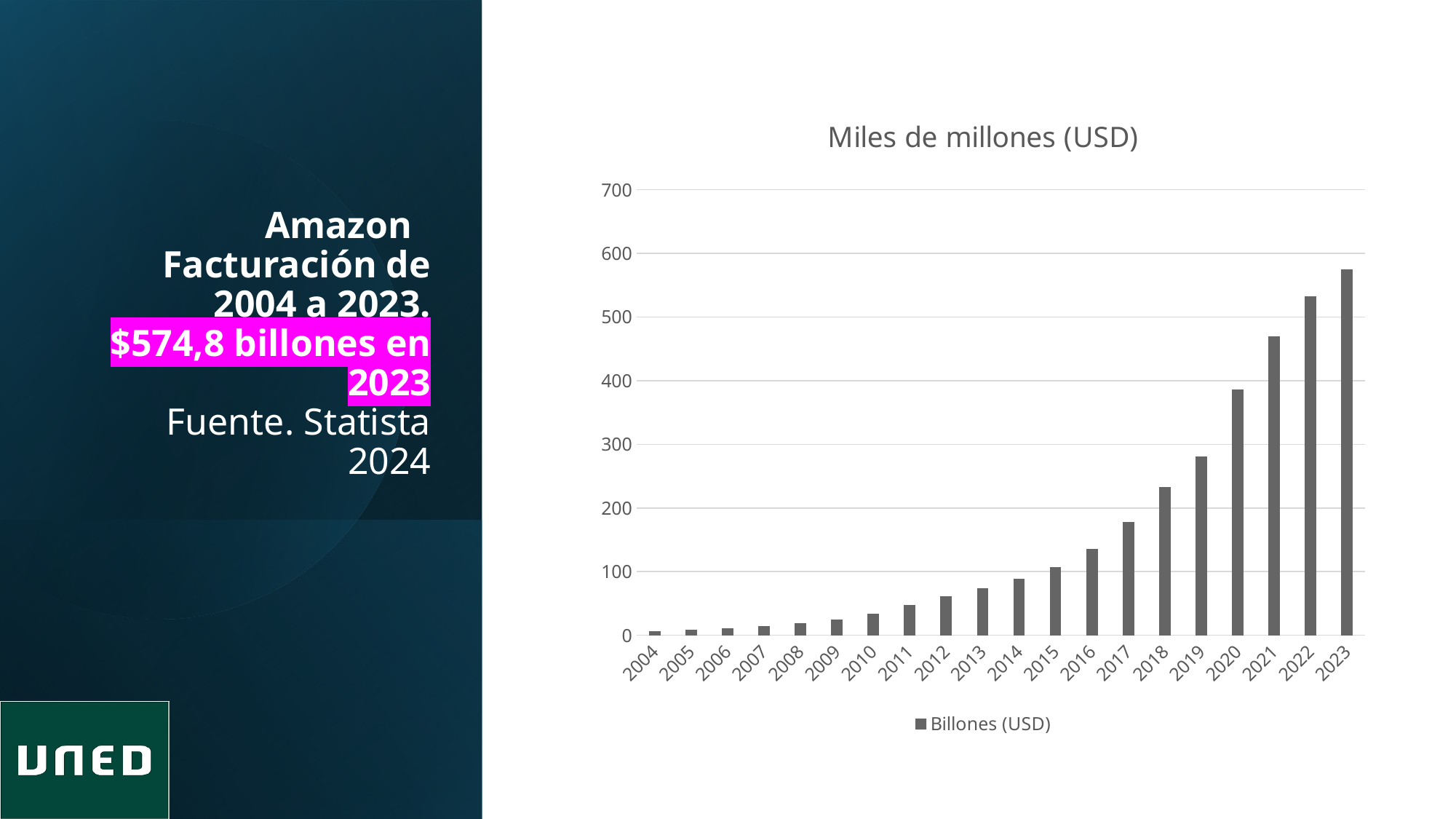
What is the name of the series shown in the legend? Billones (USD) Do the values generally rise or fall from 2004 to 2023? Rise How many series does the legend list? 1 What kind of chart is shown on the slide? Bar chart Which year has the highest bar? 2023 Is the value for 2021 greater or less than 400? greater Is the value for 2019 greater or less than 300? less What is the title of the chart? Miles de millones (USD) How many years are plotted on the x axis? 20 Is the value for 2023 greater or less than 500? greater Which is larger, the value for 2018 or the value for 2020? 2020